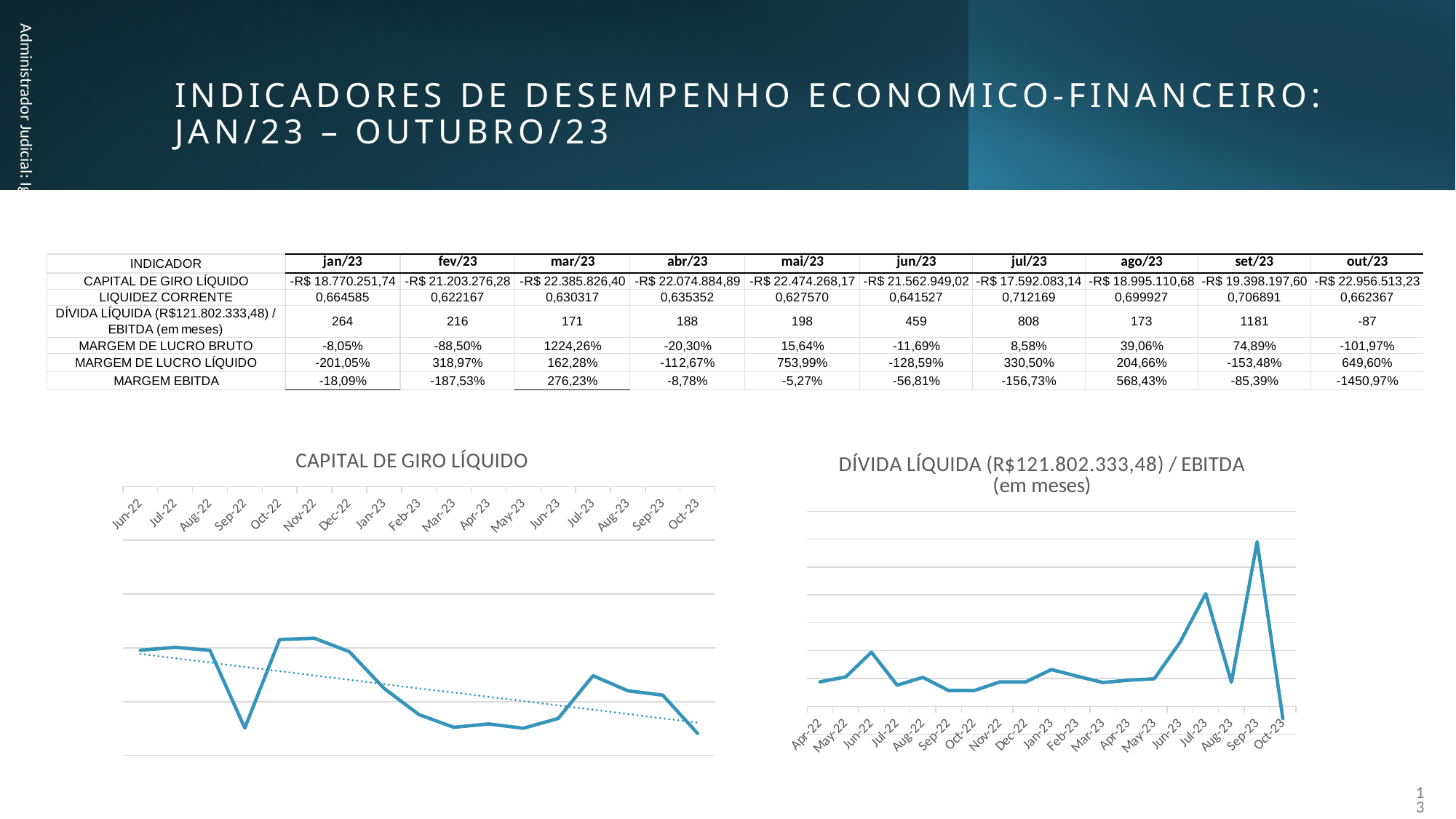
In the DÍVIDA LÍQUIDA / EBITDA chart, which month has the highest value? Sep-23 In the DÍVIDA LÍQUIDA / EBITDA chart, which month has the lowest value? Oct-23 In the CAPITAL DE GIRO LÍQUIDO chart, which month has the highest value? Nov-22 What kind of chart is the DÍVIDA LÍQUIDA (R$121.802.333,48) / EBITDA (em meses) chart? line chart What kind of chart is the CAPITAL DE GIRO LÍQUIDO chart? line chart In the CAPITAL DE GIRO LÍQUIDO chart, does the dotted trend line rise or fall from left to right? fall What is the title of the left chart on the slide? CAPITAL DE GIRO LÍQUIDO In the DÍVIDA LÍQUIDA / EBITDA chart, is the value for Jun-22 or Jul-22 larger? Jun-22 How many months are shown on the x axis of the DÍVIDA LÍQUIDA / EBITDA chart? 19 What is the first month on the x axis of the DÍVIDA LÍQUIDA / EBITDA chart? Apr-22 How many months are shown on the x axis of the CAPITAL DE GIRO LÍQUIDO chart? 17 In the DÍVIDA LÍQUIDA / EBITDA chart, is the value for Jul-23 or Aug-23 larger? Jul-23